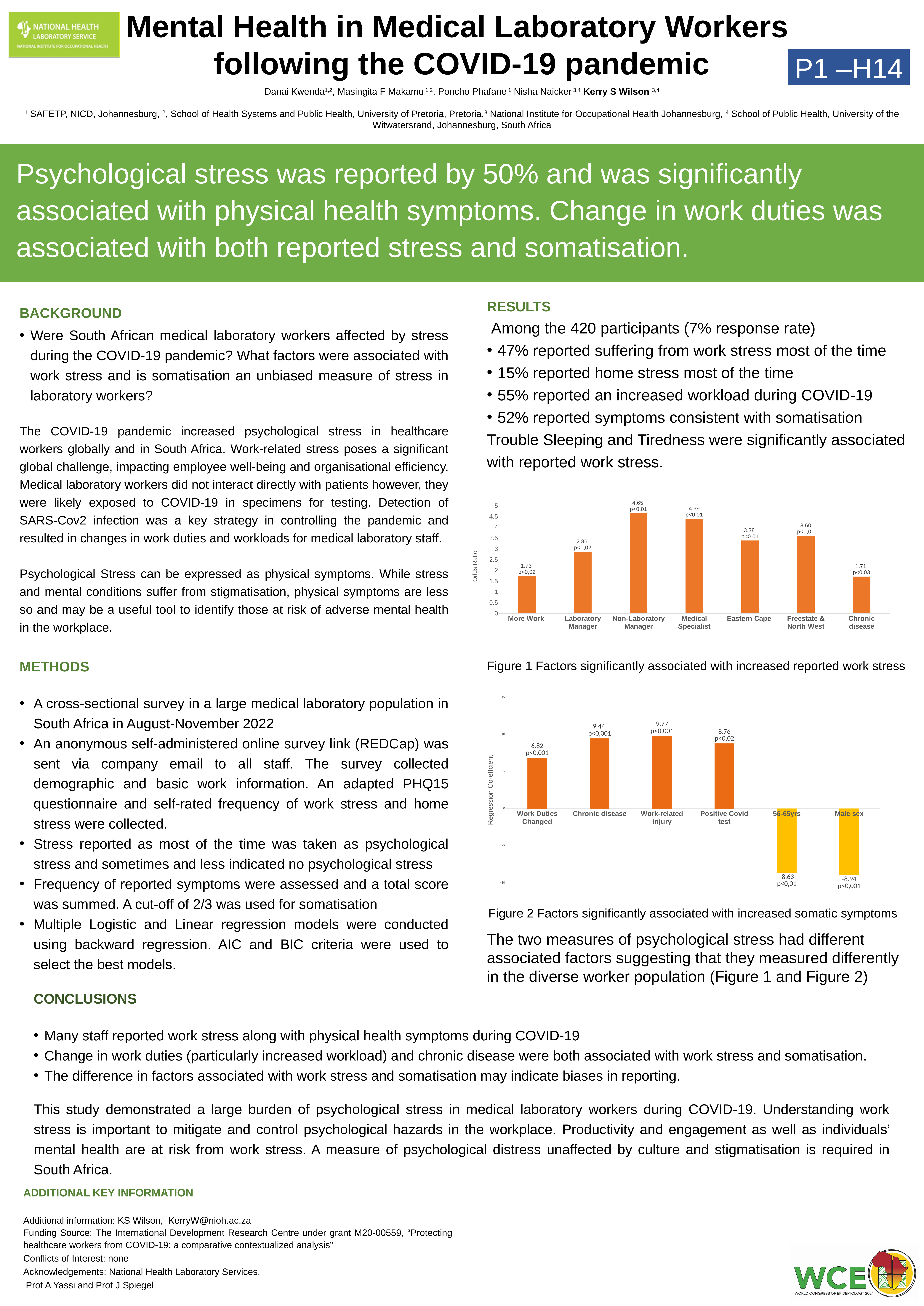
In Figure 2, how many factors are plotted? 6 In Figure 1, how many factors are plotted? 7 In Figure 1, what is the odds ratio for Eastern Cape? 3.38 In Figure 1, what is the difference between the odds ratios for Freestate & North West and Laboratory Manager? 0.74 In Figure 2, what is the regression coefficient for Male sex? -8.94 In Figure 2, which factor has the highest regression coefficient? Work-related injury In Figure 1, which has the larger odds ratio, Medical Specialist or Eastern Cape? Medical Specialist In Figure 1, which factor has the highest odds ratio? Non-Laboratory Manager In Figure 1, what is the odds ratio for Non-Laboratory Manager? 4.65 What kind of chart is Figure 1? Bar chart In Figure 2, what is the difference between the regression coefficients for Chronic disease and Positive Covid test? 0.68 In Figure 2, what is the regression coefficient for Work Duties Changed? 6.82